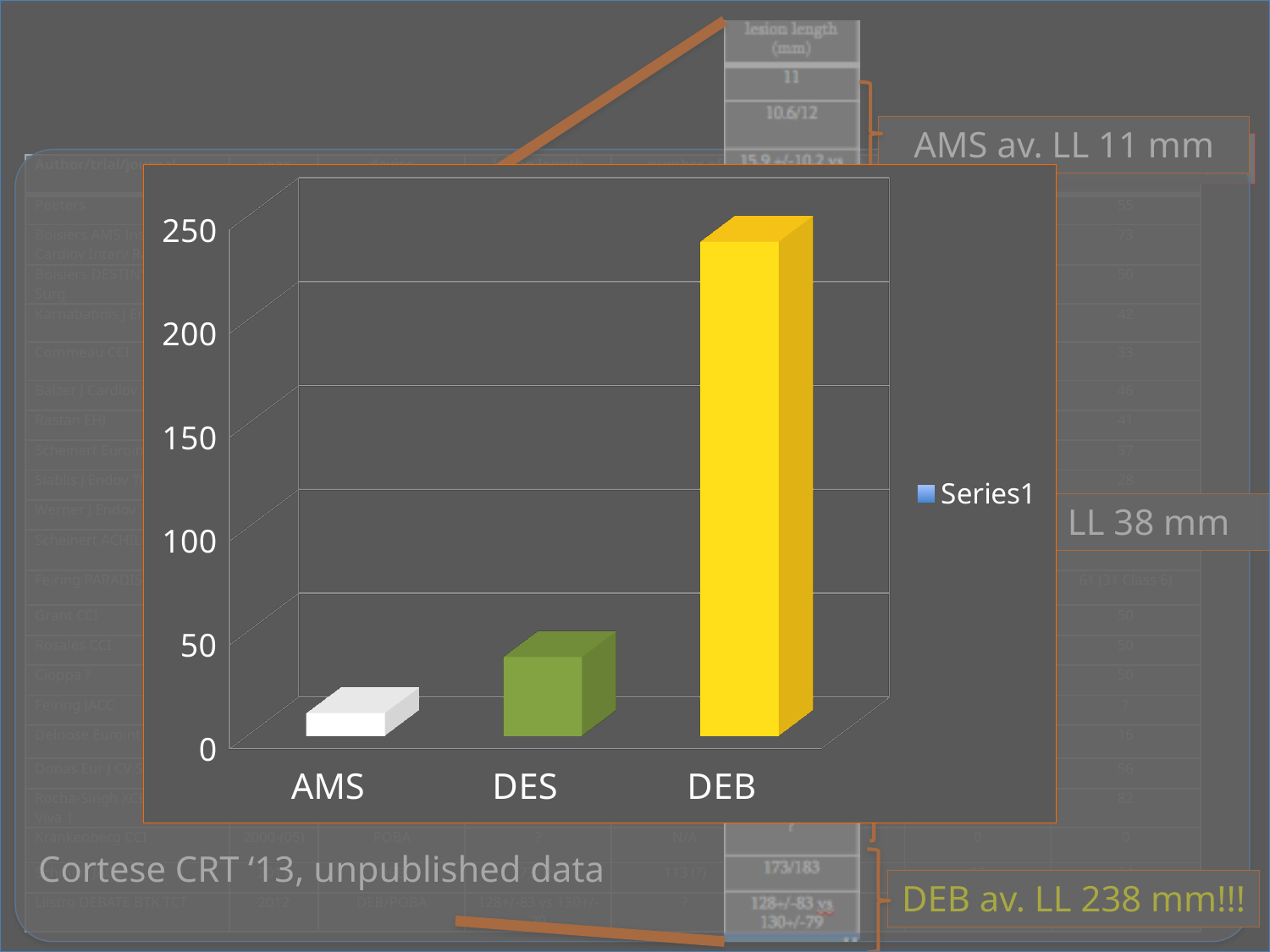
How many categories are plotted on the x axis of the chart? 3 According to the callout on the slide, what is the average lesion length for DEB? 238 mm Which category has the highest bar in the chart? DEB Do the bar values rise or fall moving from AMS to DEB along the x axis? rise Which is larger, the bar for DES or the bar for AMS? DES Which category has the lowest bar in the chart? AMS What is the name of the series shown in the chart legend? Series1 Is the value for DEB greater or less than 200? greater Is the value for DES greater or less than 50? less Is the value for AMS greater or less than 50? less How many series does the chart legend list? 1 What type of chart is shown on the slide? bar chart